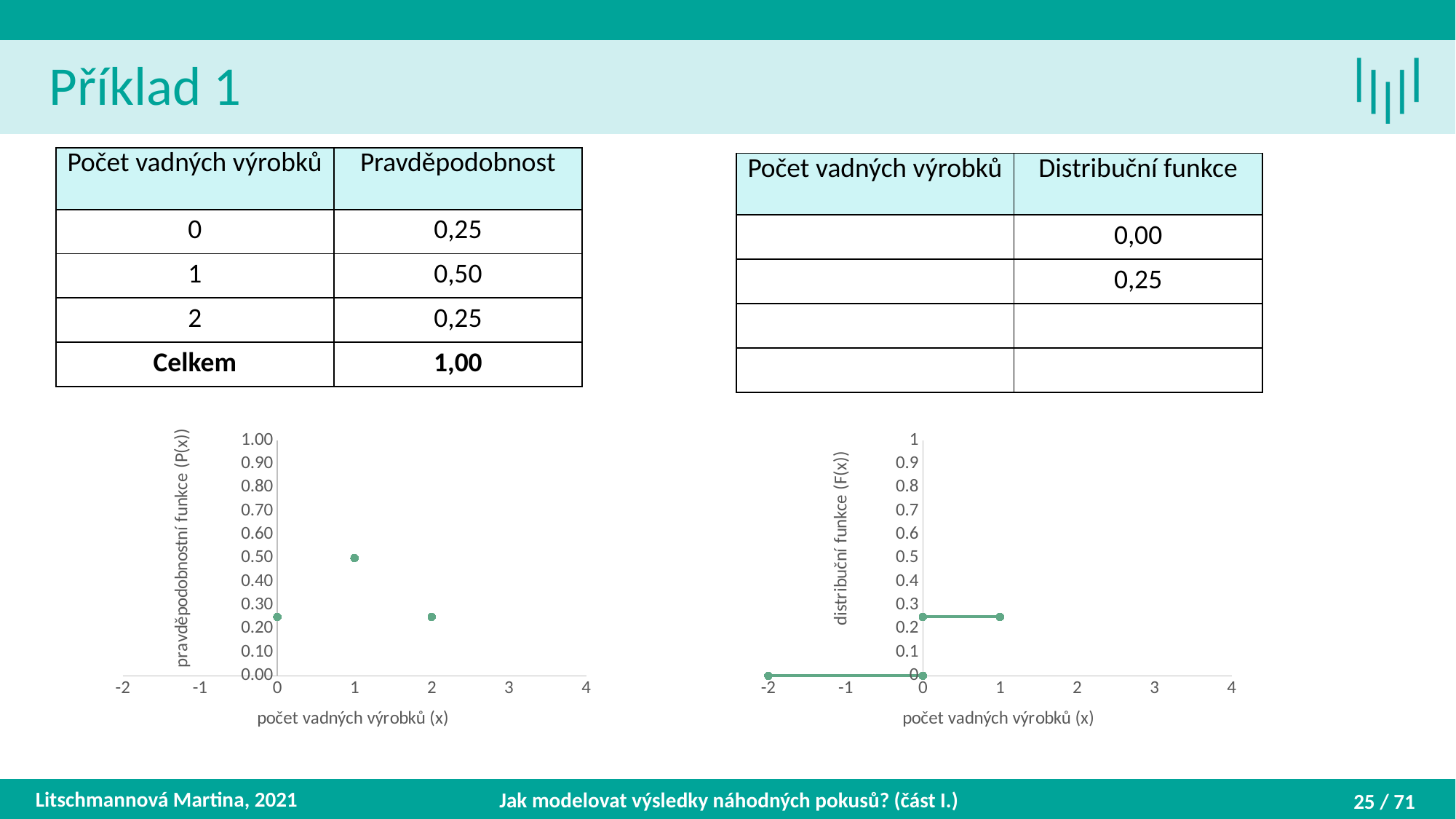
In the left chart (pravděpodobnostní funkce), which has the larger value: the point at x = 1 or the point at x = 2? x = 1 In the right chart (distribuční funkce), what is the value of F(x) on the segment from x = -2 to x = 0? 0 In the left chart (pravděpodobnostní funkce), at which value of x is the plotted point highest? 1 In the right chart (distribuční funkce), do the plotted values rise or fall as x increases? rise In the left chart (pravděpodobnostní funkce), how many data points are plotted? 3 In the left chart (pravděpodobnostní funkce), what is the value of P(x) at x = 1? 0.50 What kind of chart is the left chart (pravděpodobnostní funkce)? scatter chart In the left chart (pravděpodobnostní funkce), is the value at x = 2 greater or less than 0.30? less In the right chart (distribuční funkce), is the value on the segment from x = 0 to x = 1 greater or less than 0.2? greater In the left chart (pravděpodobnostní funkce), is the value at x = 0 greater or less than 0.20? greater What is the x-axis label of the right chart (distribuční funkce)? počet vadných výrobků (x) What is the y-axis label of the left chart? pravděpodobnostní funkce (P(x))